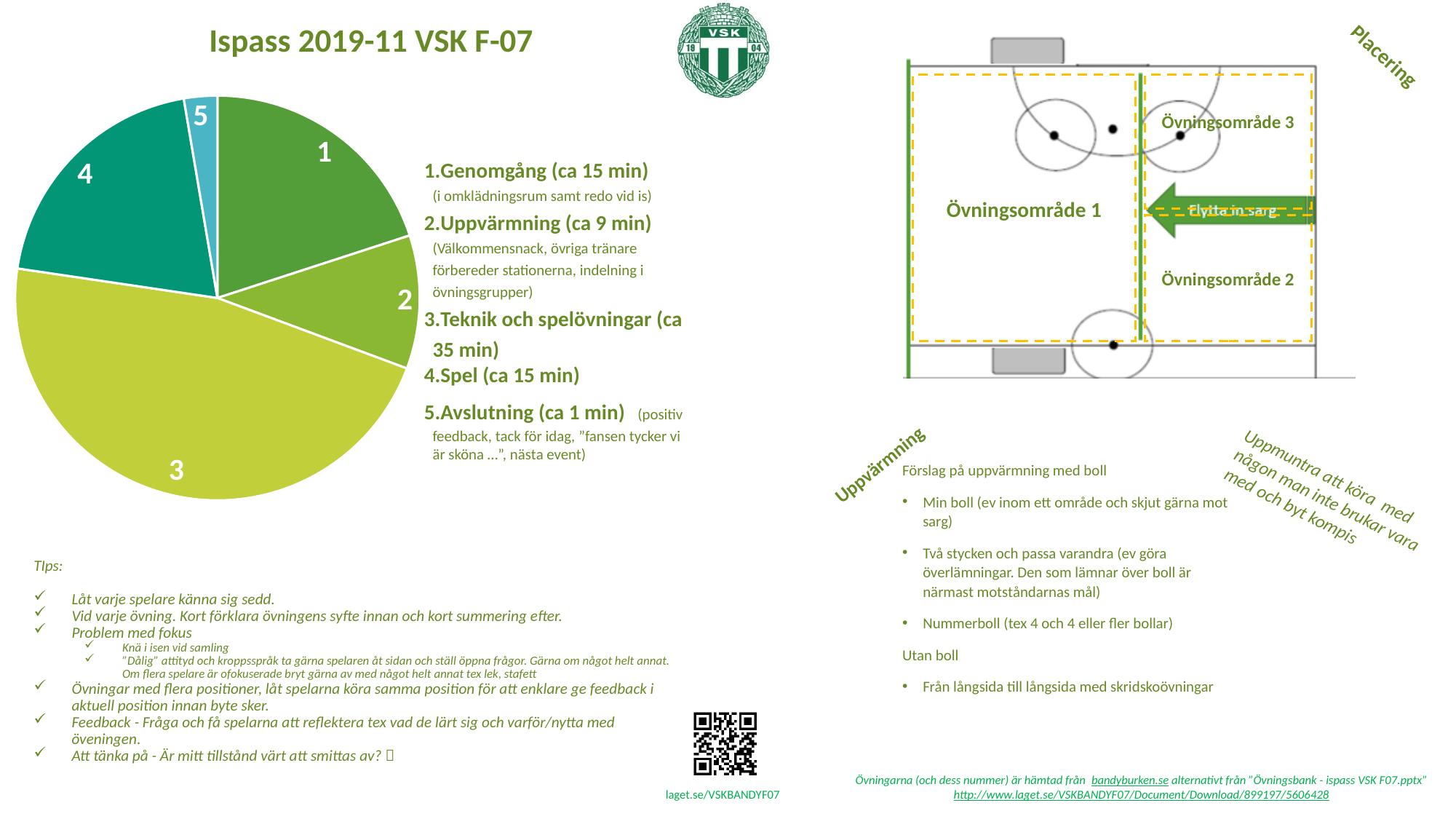
In the pie chart, which slice is larger, slice 2 or slice 5? 2 How many slices does the pie chart have? 5 According to the list next to the pie chart, how many minutes is item 5, Avslutning? ca 1 min According to the list next to the pie chart, how many minutes is item 3, Teknik och spelövningar? ca 35 min Which slice of the pie chart is the smallest? 5 In the pie chart, which slice is larger, slice 4 or slice 2? 4 What kind of chart is shown on the left of the slide? pie chart What is the title shown above the pie chart? Ispass 2019-11 VSK F-07 In the pie chart, which slice is larger, slice 3 or slice 1? 3 According to the list next to the pie chart, how many minutes is item 2, Uppvärmning? ca 9 min What colour is slice 5 of the pie chart? light blue Which slice of the pie chart is the largest? 3